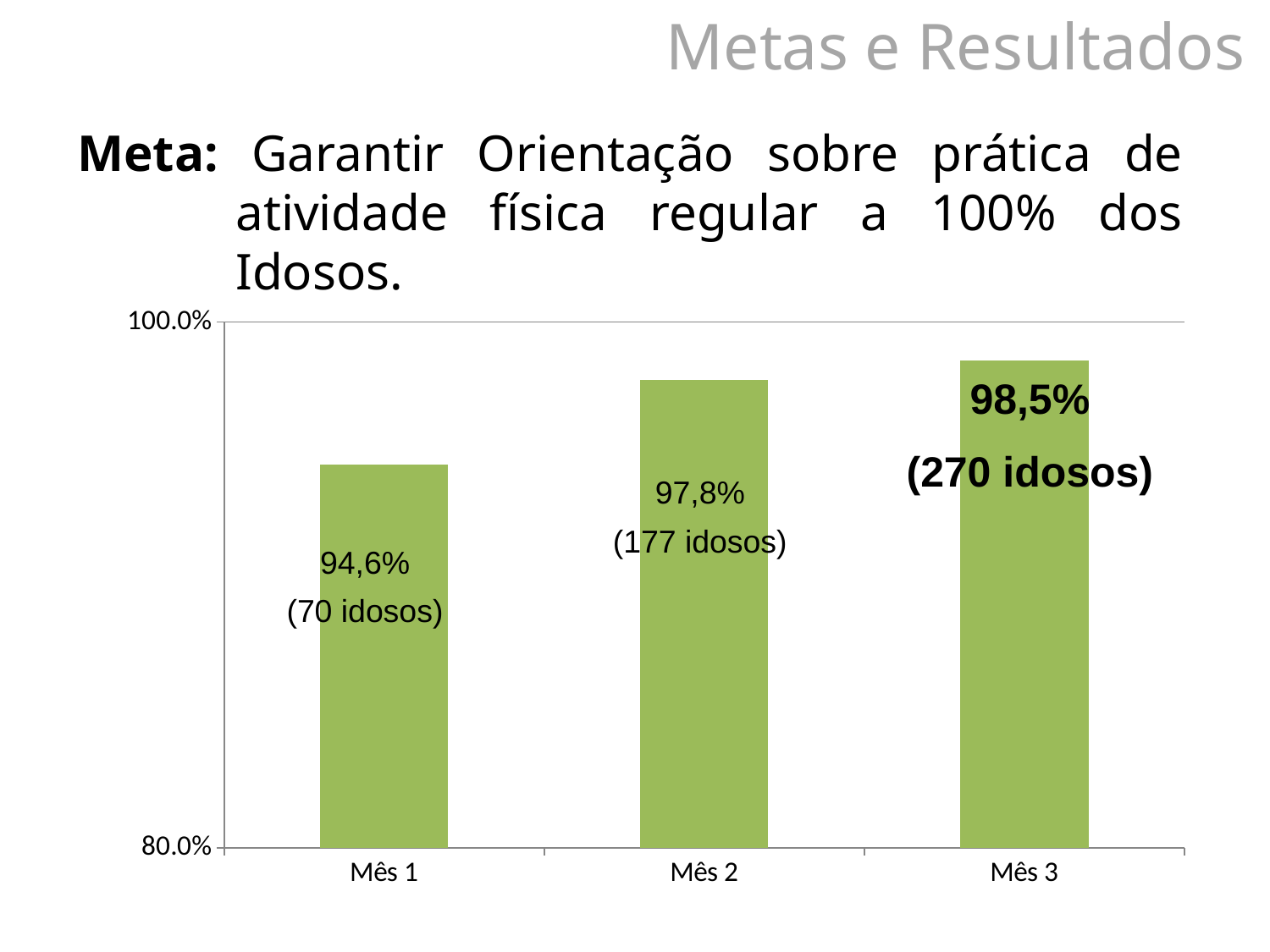
Do the percentages rise or fall from Mês 1 to Mês 3? Rise How many idosos are indicated for Mês 2? 177 idosos Which is larger, the percentage for Mês 2 or for Mês 1? Mês 2 How many idosos are indicated for Mês 3? 270 idosos What is the difference in percentage between Mês 3 and Mês 1? 3,9% What percentage is shown for Mês 1? 94,6% What kind of chart is shown on the slide? Bar chart What percentage is shown for Mês 2? 97,8% Which month has the highest percentage? Mês 3 What percentage is shown for Mês 3? 98,5% Which month has the lowest percentage? Mês 1 How many months (categories) are shown on the x axis? 3